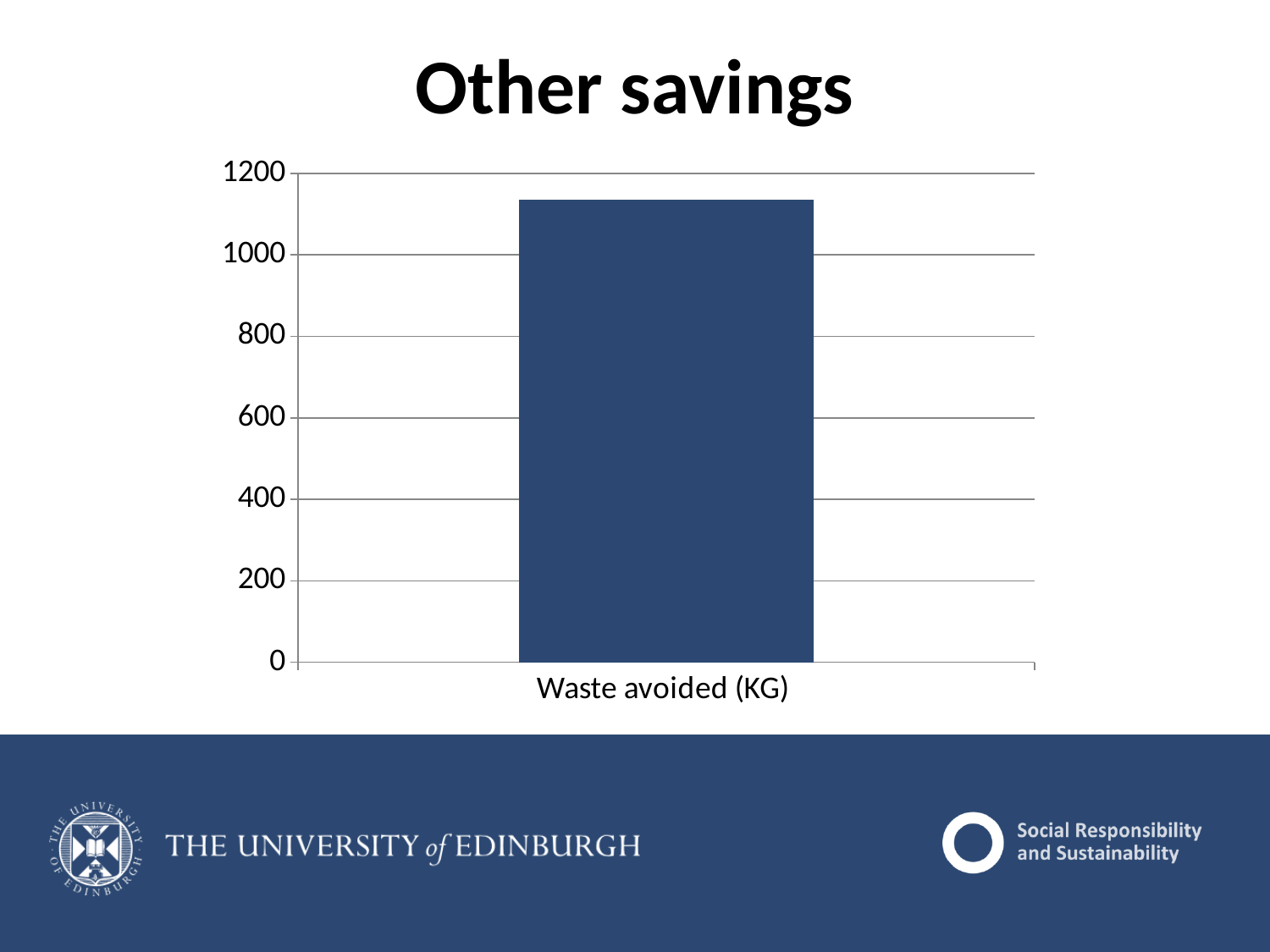
What is the highest value shown on the y axis of the chart? 1200 What kind of chart is shown on the slide? bar chart Is the value for Waste avoided (KG) greater or less than 1200? less Is the value for Waste avoided (KG) greater or less than 1000? greater Is the value for Waste avoided (KG) greater or less than 800? greater What is the title of the slide containing the chart? Other savings What is the category label on the x axis of the chart? Waste avoided (KG) How many bars does the chart show? 1